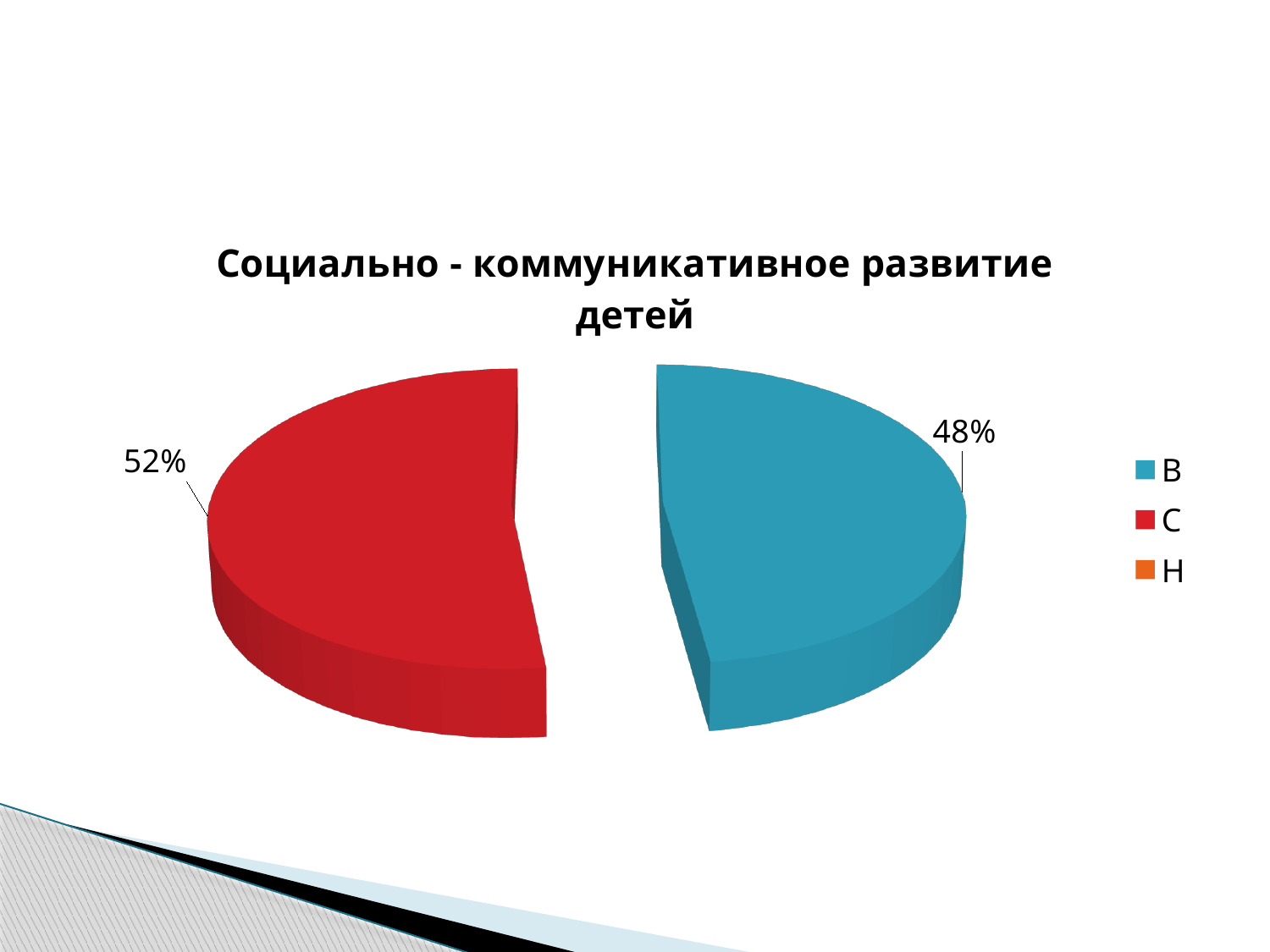
What is the chart's title? Социально - коммуникативное развитие детей What is the difference in percentage points between the С slice and the В slice? 4% Which category has the largest slice of the pie? С Which is larger, the В slice or the С slice? С Is the value for С greater or less than 50%? greater What percentage is shown for the В slice? 48% How many slices are visible in the pie? 2 What percentage is shown for the С slice? 52% Is the value for В greater or less than 50%? less How many entries does the legend list? 3 What type of chart is shown on the slide? pie chart What colour is the С slice? red